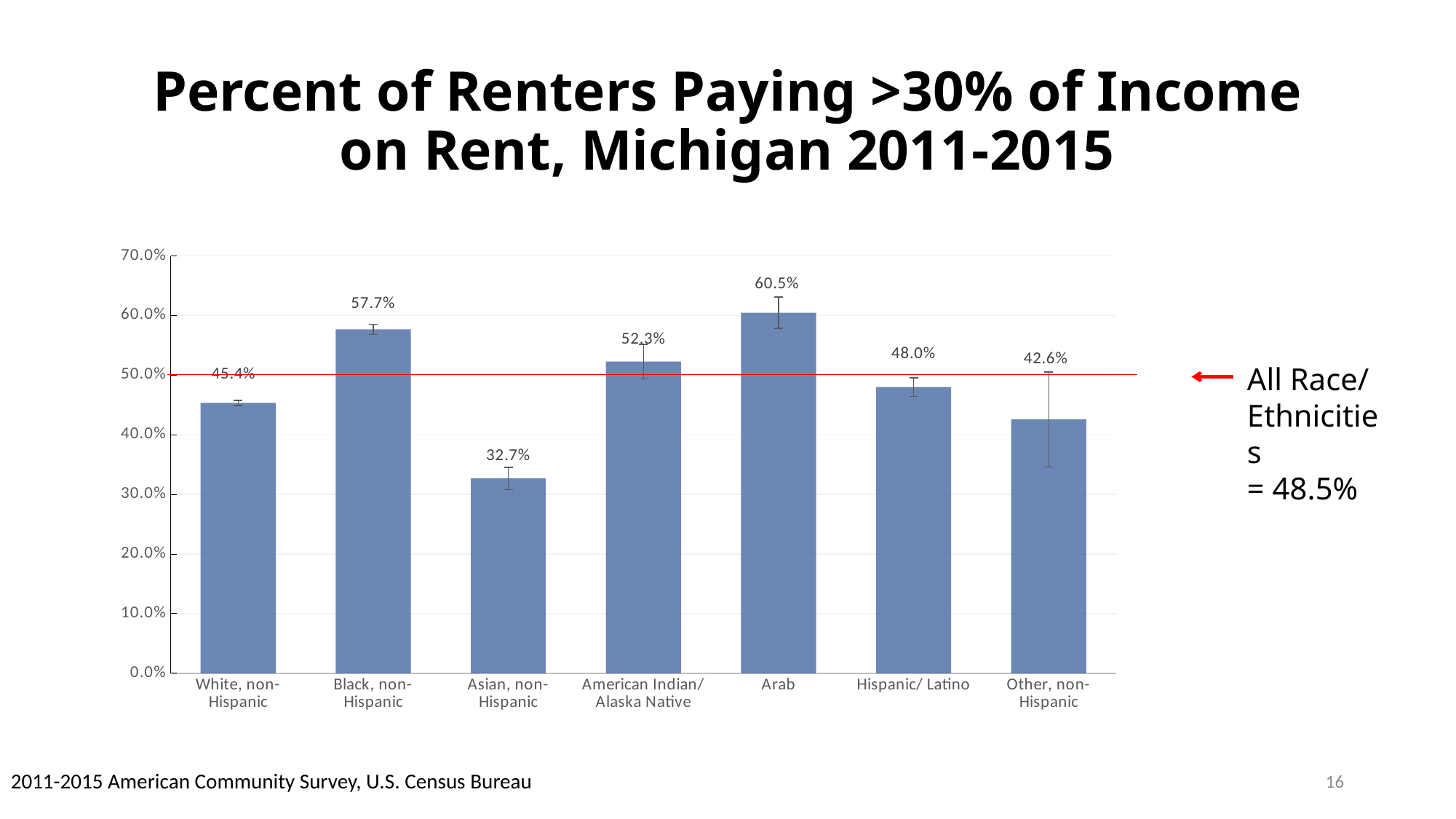
Which category has the highest value? Arab Is the value for Other, non-Hispanic greater or less than 50.0%? less How many categories are shown on the x axis? 7 What is the title of the chart? Percent of Renters Paying >30% of Income on Rent, Michigan 2011-2015 What kind of chart is shown on the slide? bar chart What is the difference between the values for Black, non-Hispanic and White, non-Hispanic? 12.3% What is the value for Asian, non-Hispanic? 32.7% What value does the red horizontal line represent, according to the annotation? All Race/Ethnicities = 48.5% Which category has the lowest value? Asian, non-Hispanic Which is larger, the value for American Indian/ Alaska Native or the value for Other, non-Hispanic? American Indian/ Alaska Native What is the value for Hispanic/ Latino? 48.0% What is the value for Arab? 60.5%